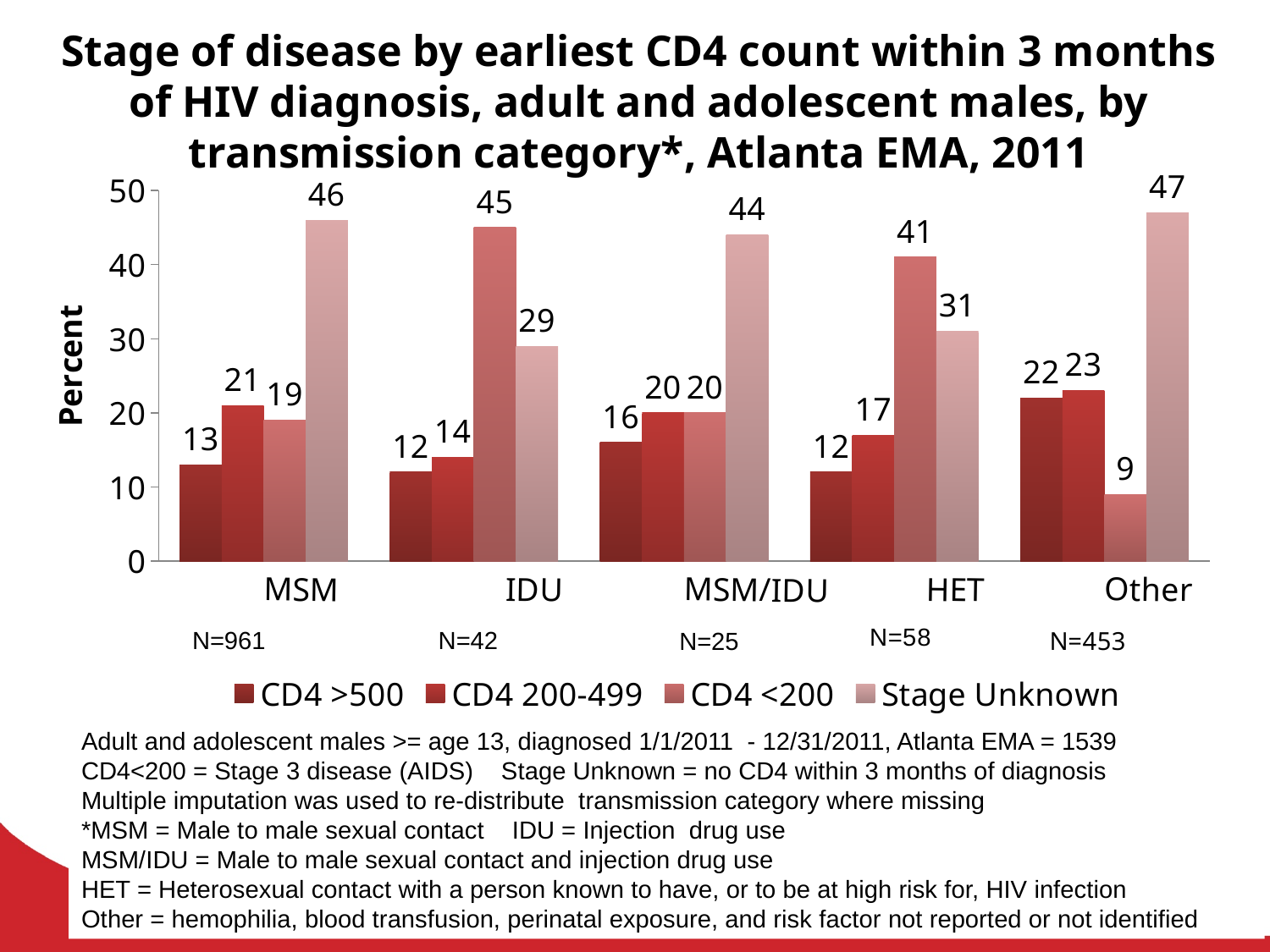
Which transmission category has the highest Stage Unknown value? Other How many transmission categories are shown on the x axis? 5 Which transmission category has the lowest CD4 <200 value? Other What is the label on the y axis? Percent What kind of chart is shown on the slide? Bar chart What is the sample size (N) shown for the IDU category? N=42 Which is larger for HET: the CD4 <200 value or the Stage Unknown value? CD4 <200 What is the Stage Unknown value for MSM? 46 What is the CD4 <200 value for HET? 41 How many series does the legend list? 4 What is the CD4 >500 value for MSM/IDU? 16 What is the difference between the CD4 <200 value for IDU and the CD4 <200 value for MSM? 26